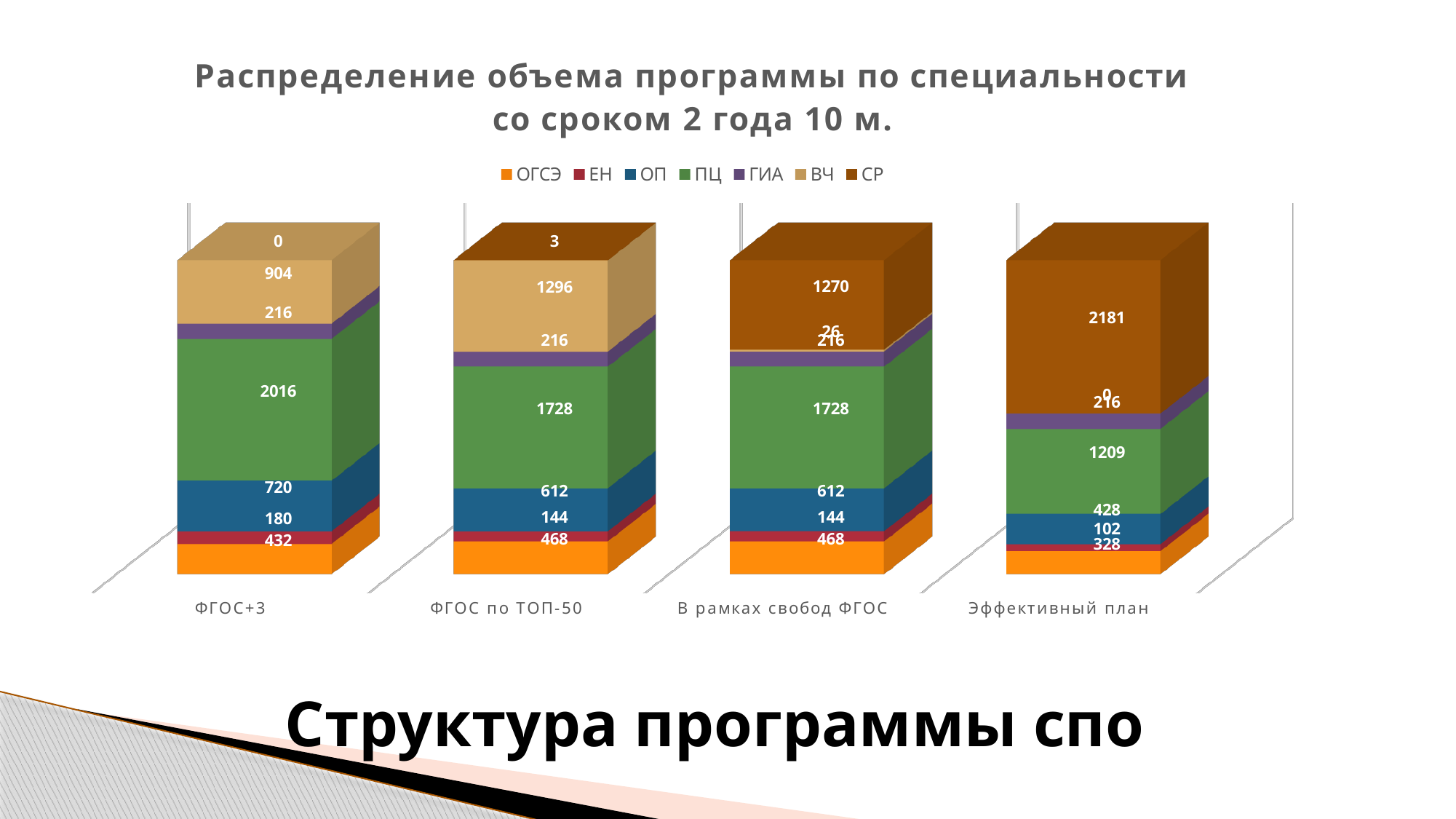
What is the value of ПЦ for ФГОС+3? 2016 Which category has the highest value for ПЦ? ФГОС+3 What kind of chart is shown on the slide? Stacked bar chart What is the value of СР for ФГОС по ТОП-50? 3 Which has the larger ОГСЭ value, ФГОС+3 or ФГОС по ТОП-50? ФГОС по ТОП-50 What is the value of ОП for В рамках свобод ФГОС? 612 How many series does the legend list? 7 What is the difference between the ПЦ value for ФГОС+3 and the ПЦ value for ФГОС по ТОП-50? 288 How many categories are shown along the x axis? 4 Which category has the lowest value for ОП? Эффективный план What is the value of СР for Эффективный план? 2181 What is the value of ВЧ for ФГОС по ТОП-50? 1296